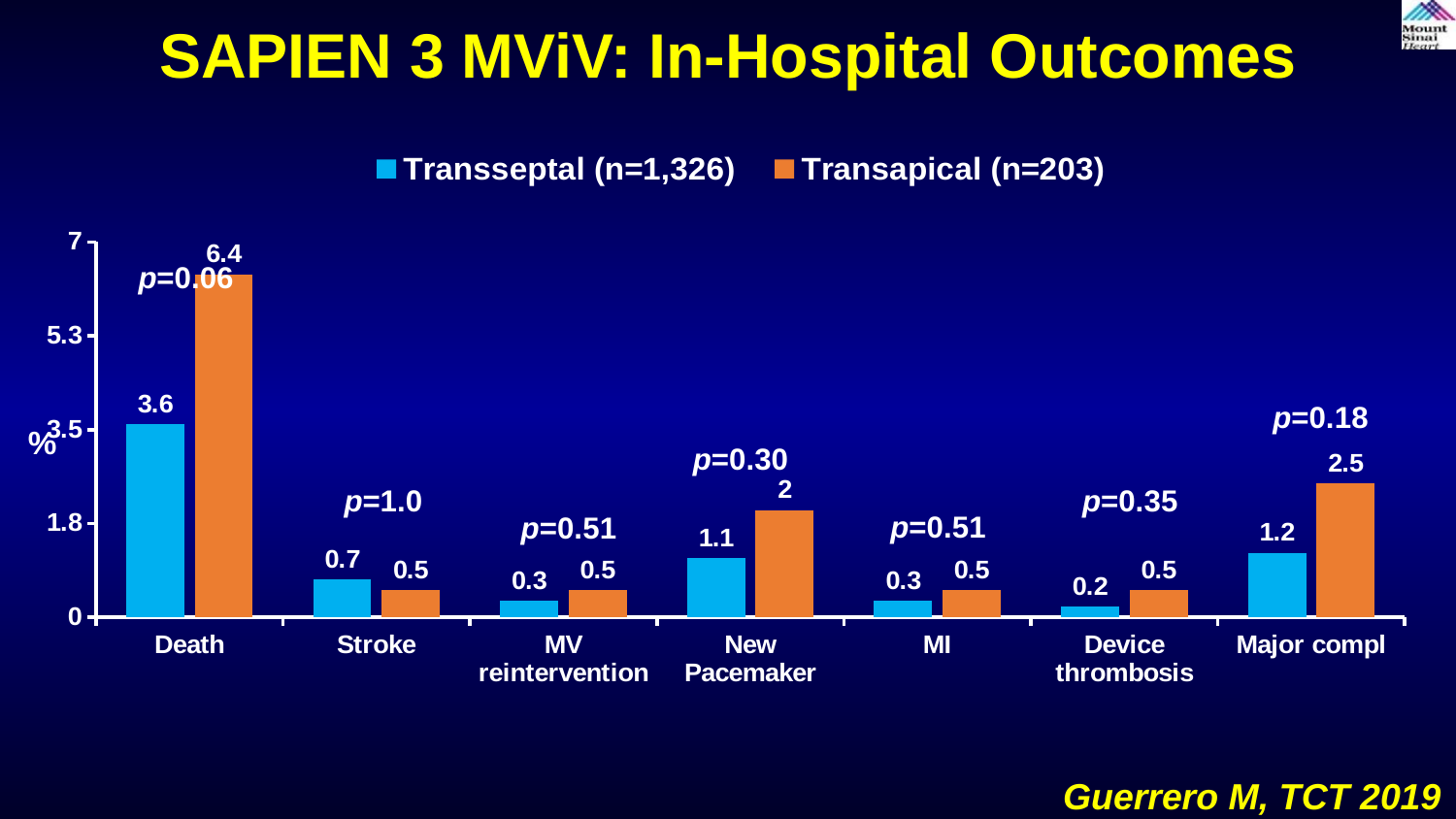
How many series does the legend list? 2 What is the difference between the Transapical and Transseptal values for Death? 2.8 What is the Transapical value for Death? 6.4 How many categories are shown on the x axis? 7 Which category has the lowest Transseptal value? Device thrombosis What is the Transseptal value for Major compl? 1.2 What kind of chart is shown on the slide? bar chart What is the p-value shown above the Death bars? p=0.06 Which category has the highest Transapical value? Death Which is larger for Stroke: the Transseptal value or the Transapical value? Transseptal What is the Transseptal value for Device thrombosis? 0.2 Is the Transapical value for Major compl greater or less than 1.8? greater